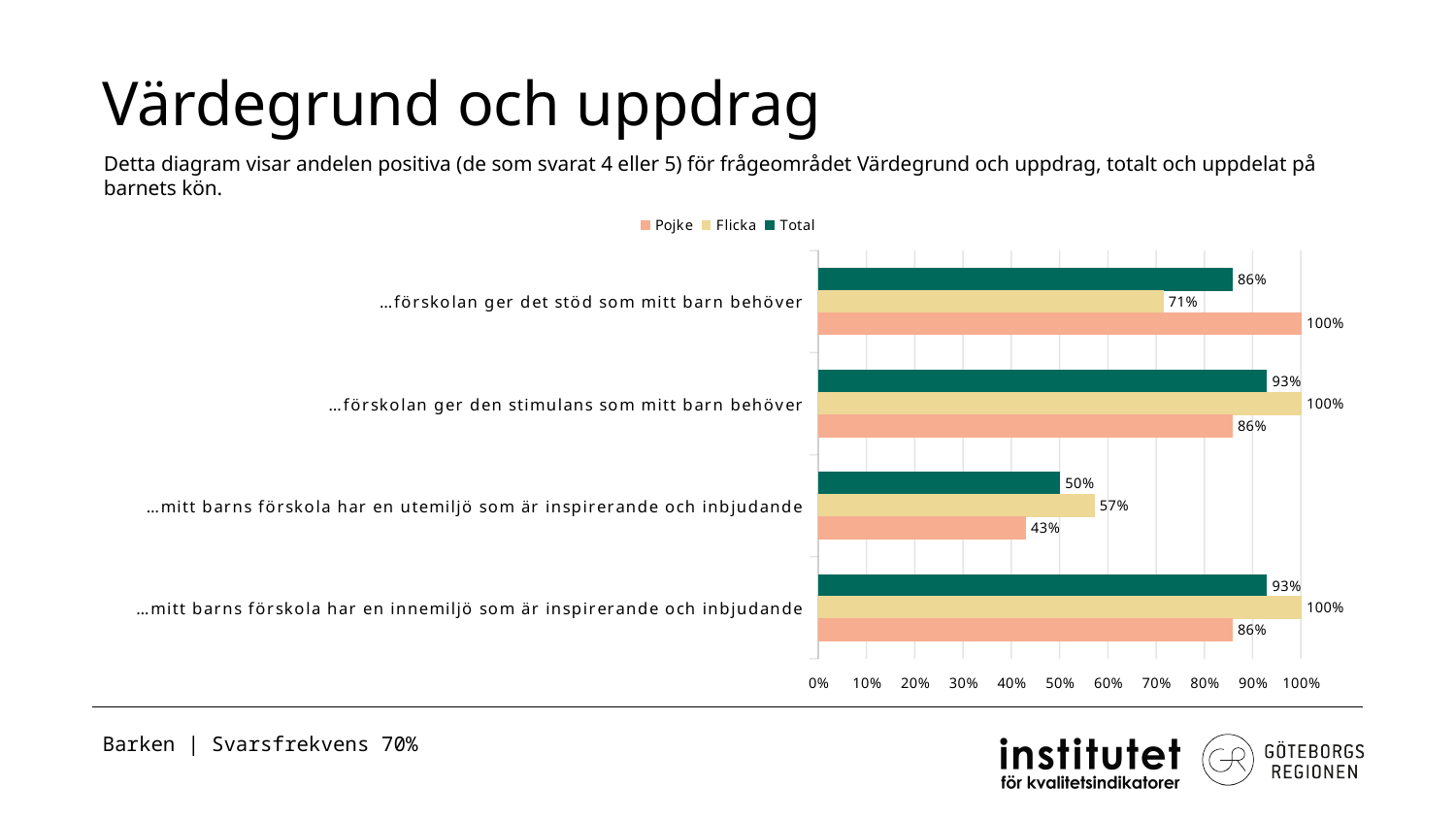
What is the Flicka value for "…förskolan ger det stöd som mitt barn behöver"? 71% For "…förskolan ger den stimulans som mitt barn behöver", which is larger, the Flicka value or the Pojke value? Flicka How many categories are shown on the chart? 4 What is the Pojke value for "…förskolan ger det stöd som mitt barn behöver"? 100% Which category has the lowest Pojke value? …mitt barns förskola har en utemiljö som är inspirerande och inbjudande Which category has the lowest Total value? …mitt barns förskola har en utemiljö som är inspirerande och inbjudande Which series is shown in green in the legend? Total What is the Pojke value for "…mitt barns förskola har en innemiljö som är inspirerande och inbjudande"? 86% How many series does the legend list? 3 What is the Total value for "…mitt barns förskola har en utemiljö som är inspirerande och inbjudande"? 50% What kind of chart is shown on the slide? Bar chart What is the difference between the Flicka and Pojke values for "…mitt barns förskola har en utemiljö som är inspirerande och inbjudande"? 14%